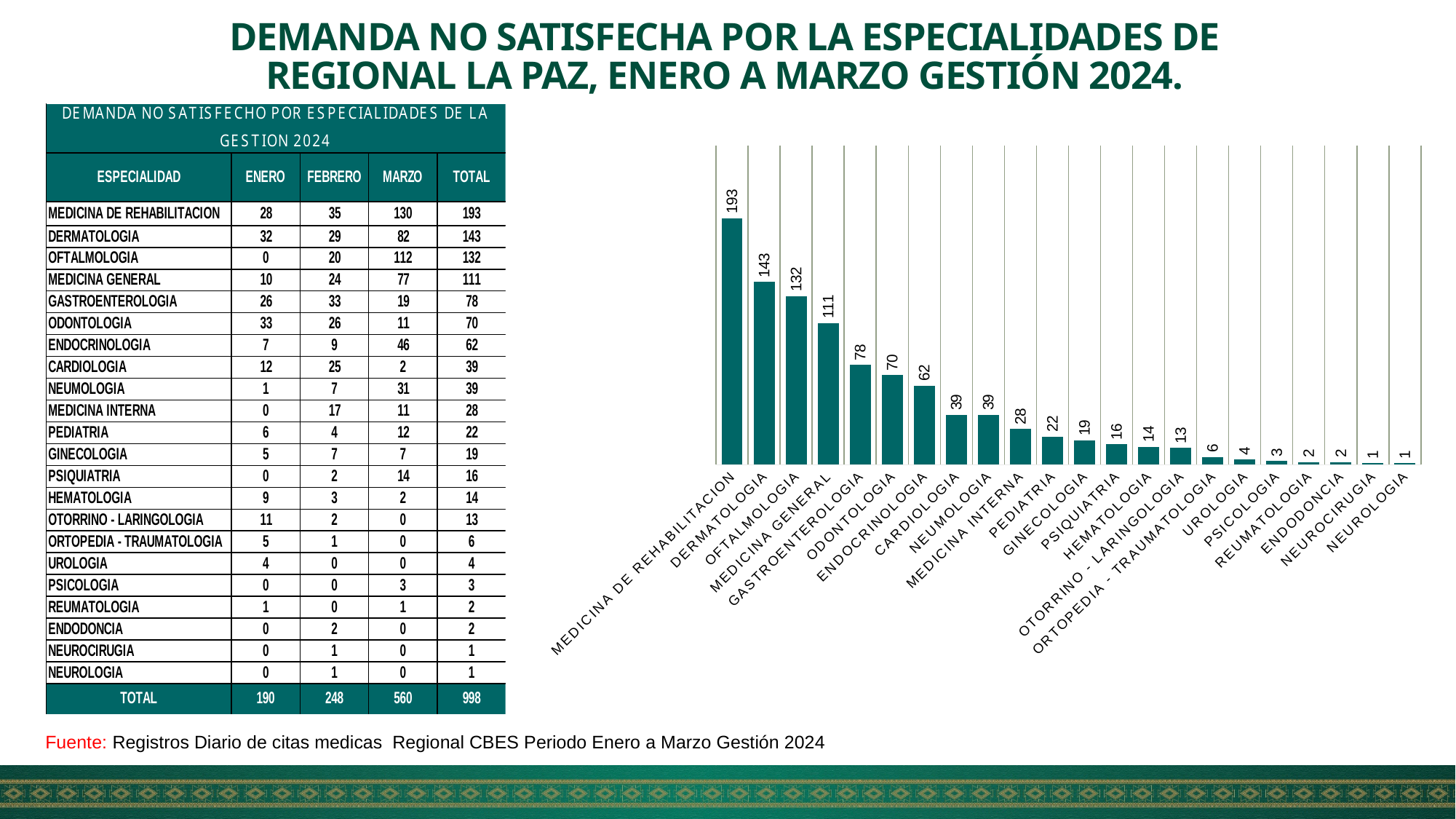
What is the value for PSIQUIATRIA in the bar chart? 16 What is the value for ENDOCRINOLOGIA in the bar chart? 62 What kind of chart is shown on the slide? bar chart In the bar chart, which is larger: the value for HEMATOLOGIA or the value for UROLOGIA? HEMATOLOGIA What is the value for OFTALMOLOGIA in the bar chart? 132 In the bar chart, which is larger: the value for PEDIATRIA or the value for GINECOLOGIA? PEDIATRIA What is the difference between the values for DERMATOLOGIA and MEDICINA GENERAL in the bar chart? 32 What is the value for MEDICINA DE REHABILITACION in the bar chart? 193 What is the difference between the values for GASTROENTEROLOGIA and ODONTOLOGIA in the bar chart? 8 Which category has the highest value in the bar chart? MEDICINA DE REHABILITACION Do the values in the bar chart rise or fall from left to right along the x axis? fall How many categories are plotted in the bar chart? 22